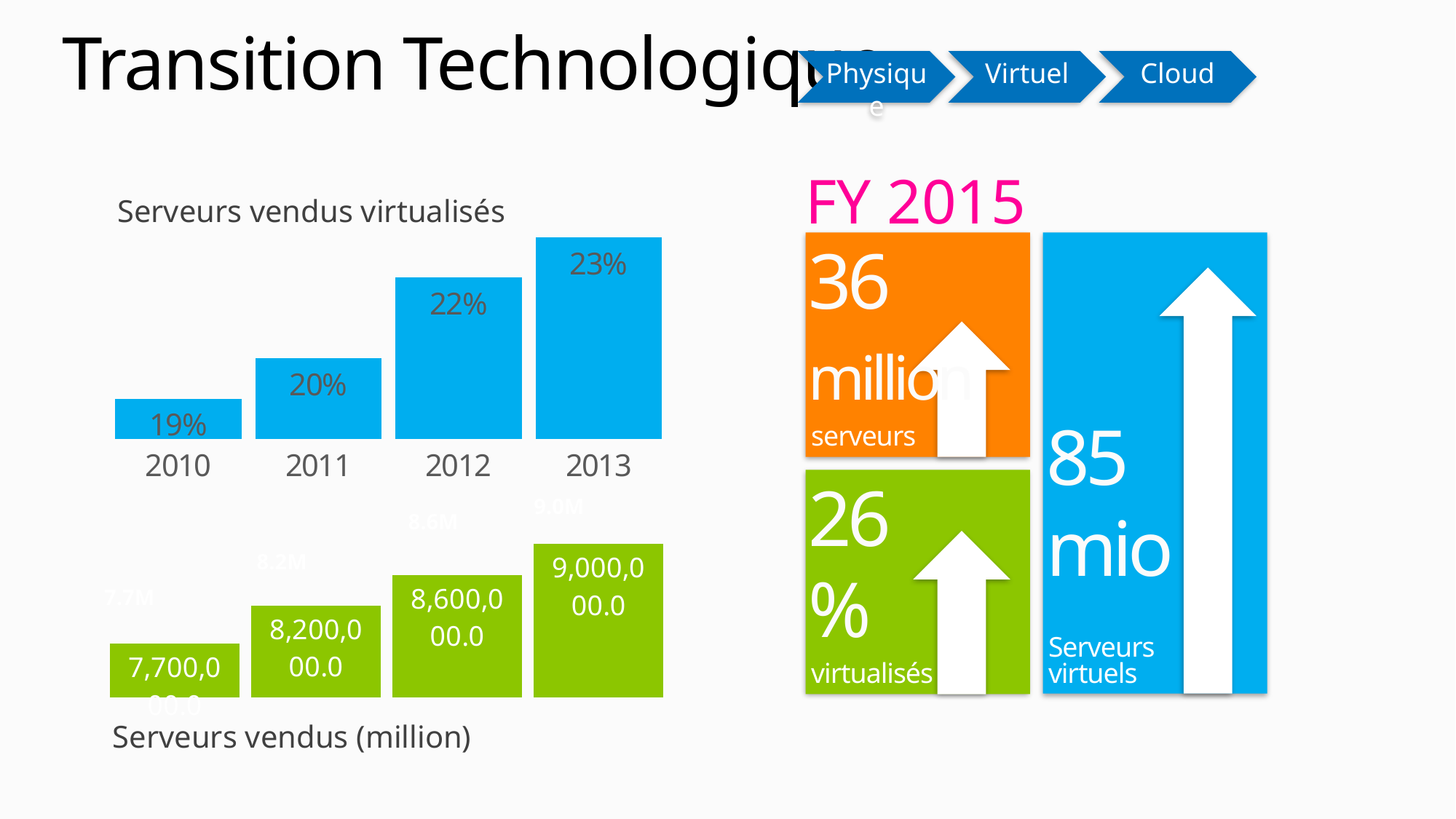
In the 'Serveurs vendus virtualisés' chart, what is the value for 2012? 22% How many years are shown in the 'Serveurs vendus virtualisés' chart? 4 In the 'Serveurs vendus virtualisés' chart, what is the difference between the values for 2013 and 2011? 3% In the 'Serveurs vendus virtualisés' chart, what is the value for 2010? 19% In the 'Serveurs vendus virtualisés' chart, which year has the highest value? 2013 In the 'Serveurs vendus virtualisés' chart, which is larger, the value for 2011 or the value for 2012? 2012 In the 'Serveurs vendus virtualisés' chart, which year has the lowest value? 2010 In the 'Serveurs vendus (million)' chart, what is the value of the tallest bar? 9,000,000.0 What kind of chart is the 'Serveurs vendus (million)' chart at the bottom left of the slide? bar chart In the 'Serveurs vendus (million)' chart, what is the value of the first (leftmost) bar? 7,700,000.0 Do the values in the 'Serveurs vendus virtualisés' chart rise or fall from 2010 to 2013? rise What colour are the bars in the 'Serveurs vendus (million)' chart? green